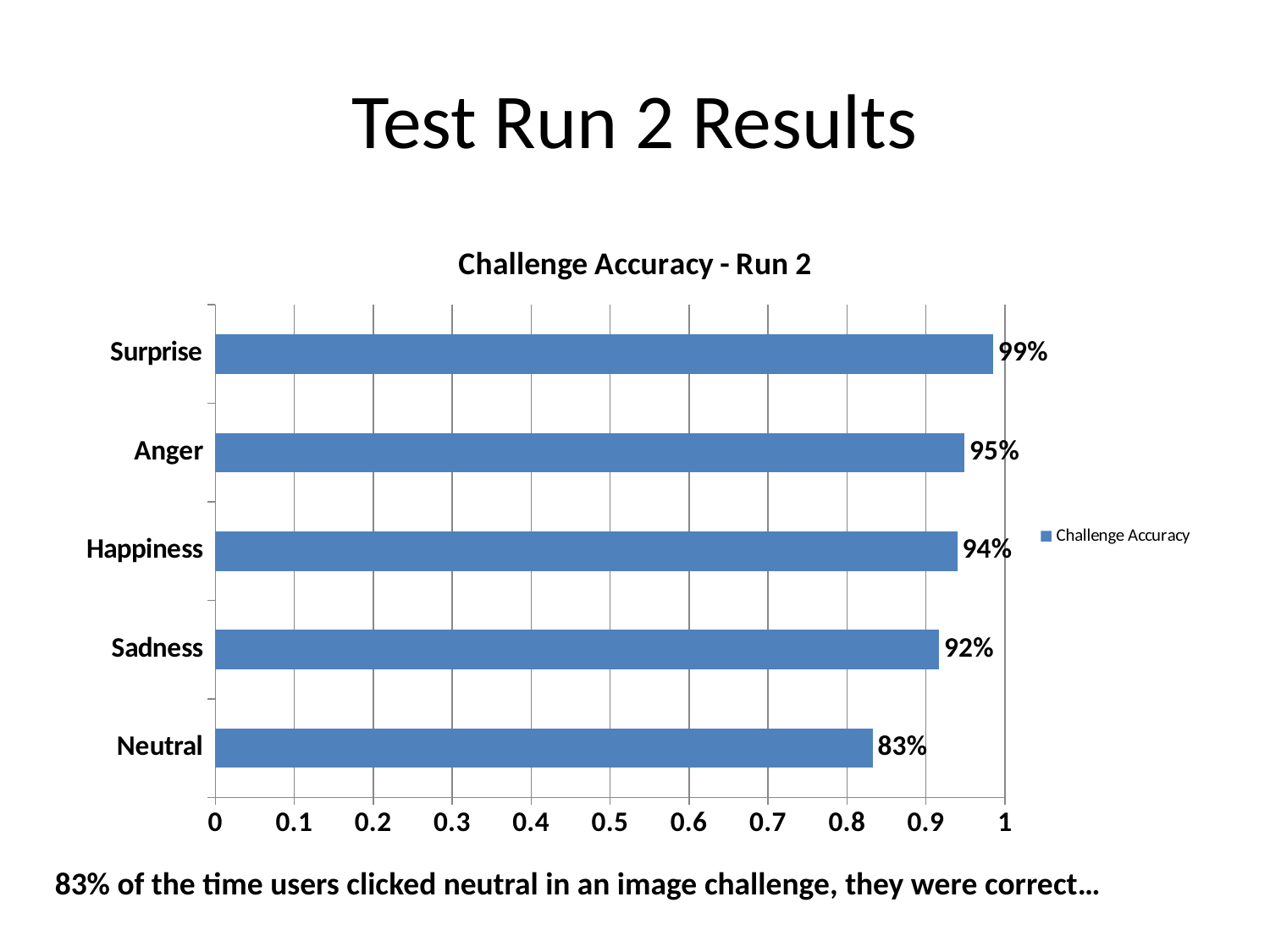
Which category has the lowest Challenge Accuracy? Neutral What is the Challenge Accuracy value for Neutral? 83% What is the Challenge Accuracy value for Surprise? 99% What kind of chart is shown on the slide? Bar chart Which has a higher Challenge Accuracy, Sadness or Anger? Anger How many categories are shown in the chart? 5 What is the Challenge Accuracy value for Sadness? 92% What is the title of the chart? Challenge Accuracy - Run 2 Is the value for Neutral greater or less than 0.9? less Which category has the highest Challenge Accuracy? Surprise What is the difference between the Challenge Accuracy for Surprise and Neutral? 16% What is the difference between the Challenge Accuracy for Anger and Happiness? 1%